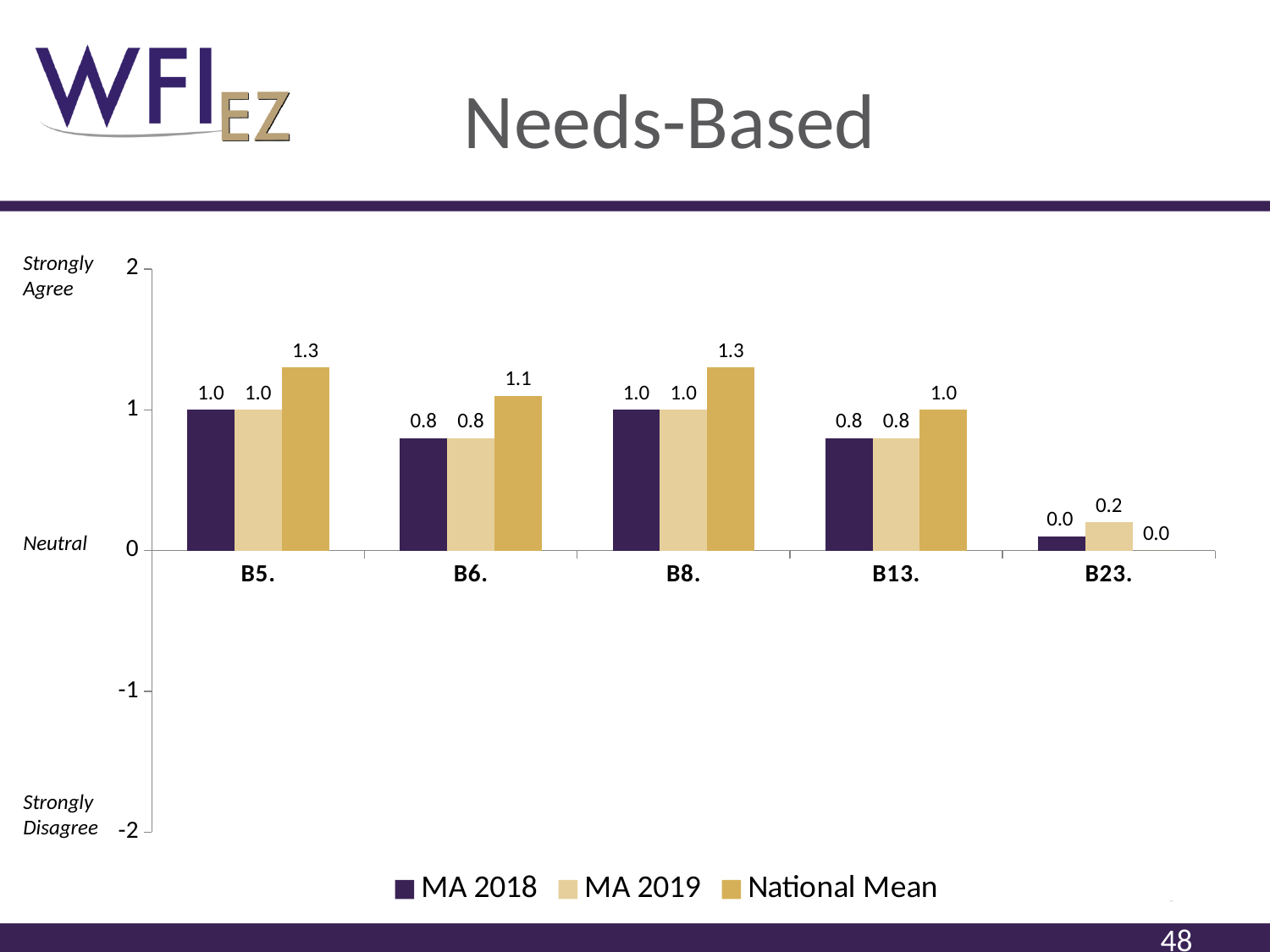
How many categories are shown on the x axis? 5 What label appears at the top of the y axis next to the value 2? Strongly Agree What kind of chart is shown on the slide? bar chart What is the National Mean value for B5.? 1.3 What is the title of the slide? Needs-Based For B13., is the National Mean value larger or smaller than the MA 2018 value? larger Which category has the lowest National Mean value? B23. What is the MA 2018 value for B8.? 1.0 What is the MA 2019 value for B6.? 0.8 What is the MA 2019 value for B23.? 0.2 How many series does the legend list? 3 What is the difference between the National Mean and MA 2019 values for B6.? 0.3